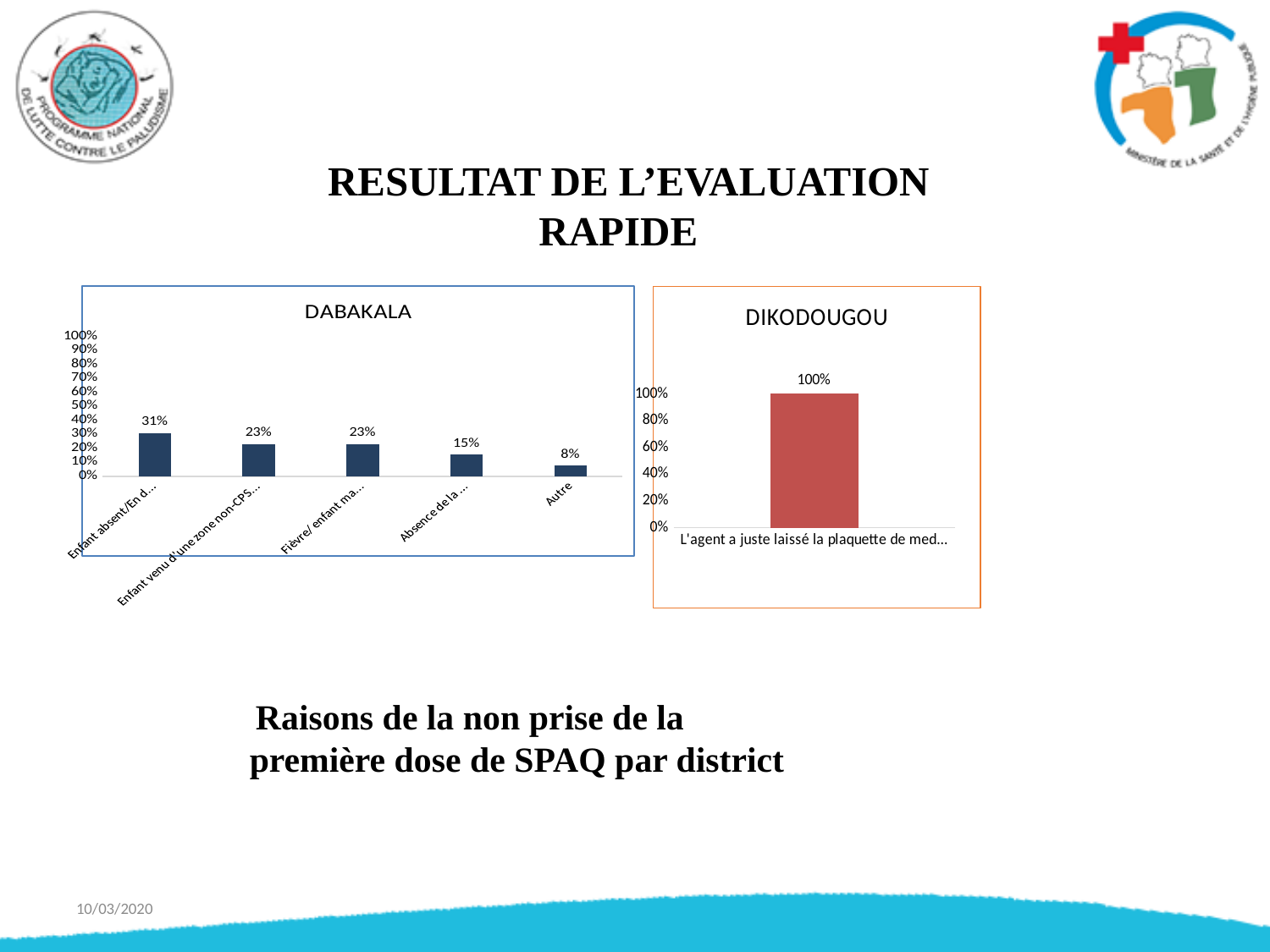
In the DABAKALA chart, is the value for "Autre" greater or less than 10%? less How many bars are plotted in the DIKODOUGOU chart? 1 What type of chart is the DIKODOUGOU chart? bar chart What is the title of the chart on the left of the slide? DABAKALA How many bars are plotted in the DABAKALA chart? 5 In the DABAKALA chart, what is the value for the category "Autre"? 8% In the DIKODOUGOU chart, what is the value of the single bar? 100% In the DABAKALA chart, what is the difference between the highest bar (31%) and the "Autre" bar (8%)? 23% In the DABAKALA chart, which category has the highest value? Enfant absent/En d... In the DABAKALA chart, which is larger: the first bar (Enfant absent) or the fourth bar (Absence de la ...)? Enfant absent/En d... In the DABAKALA chart, what is the value of the first bar, labelled "Enfant absent/En d..."? 31% In the DABAKALA chart, which category has the lowest value? Autre